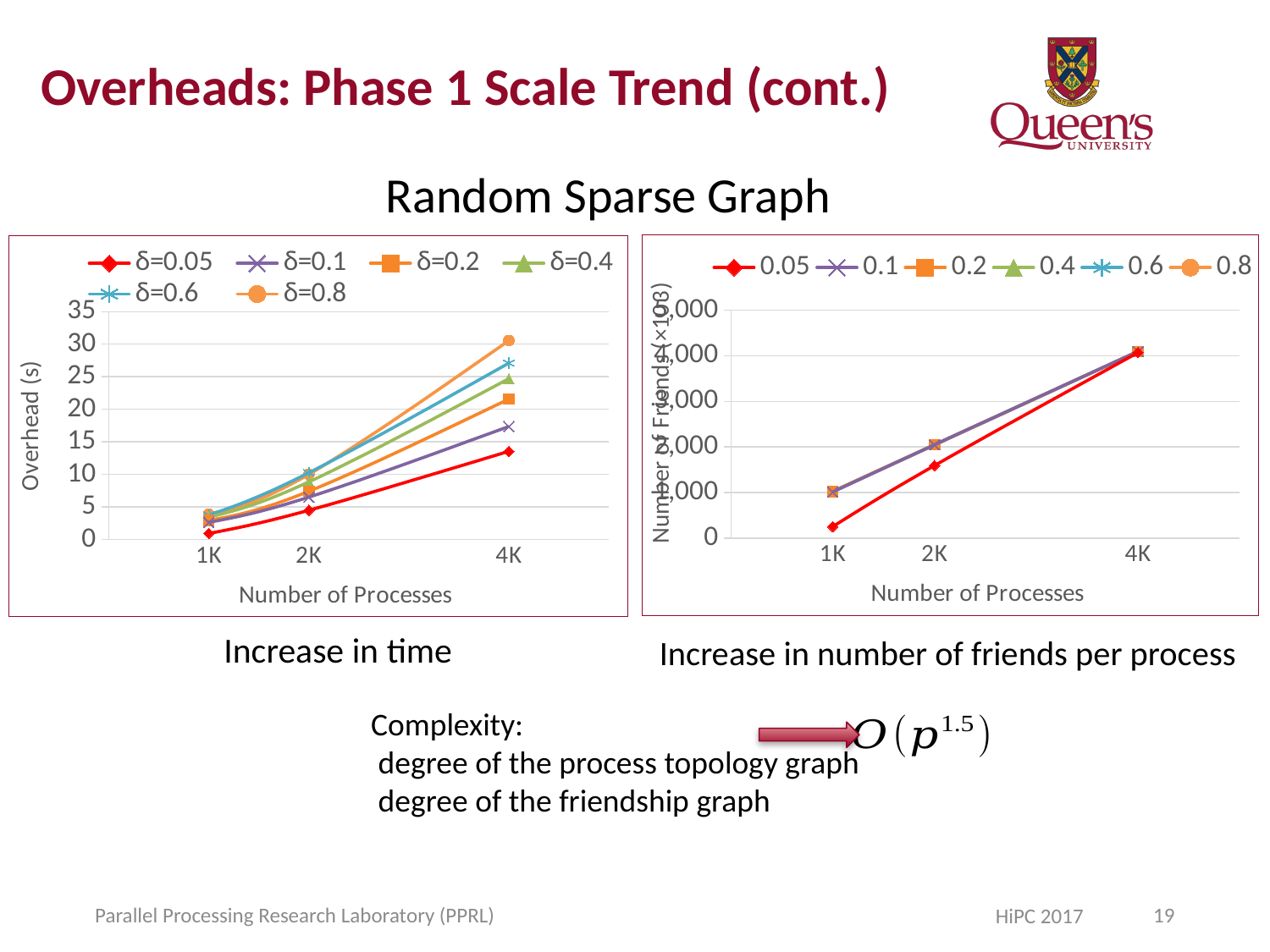
In the right chart (Increase in number of friends per process), is the value for the 0.05 series at 1K processes greater or less than 1,000? less How many process counts are shown on the x axis of the right chart (Increase in number of friends per process)? 3 In the left chart (Increase in time), which is larger at 4K processes: the overhead for δ=0.2 or for δ=0.1? δ=0.2 In the left chart (Increase in time), which series has the lowest overhead at 4K processes? δ=0.05 In the left chart (Increase in time), does the overhead for δ=0.6 rise or fall as the number of processes increases? rise What kind of chart is the left chart (Increase in time)? line chart In the right chart (Increase in number of friends per process), which series has the lowest value at 1K processes? 0.05 In the left chart (Increase in time), which series has the highest overhead at 4K processes? δ=0.8 How many series does the legend of the left chart (Increase in time) list? 6 What is the label of the y axis of the left chart (Increase in time)? Overhead (s) In the left chart (Increase in time), is the overhead for δ=0.05 at 4K processes greater or less than 15? less In the left chart (Increase in time), is the overhead for δ=0.8 at 4K processes greater or less than 25? greater